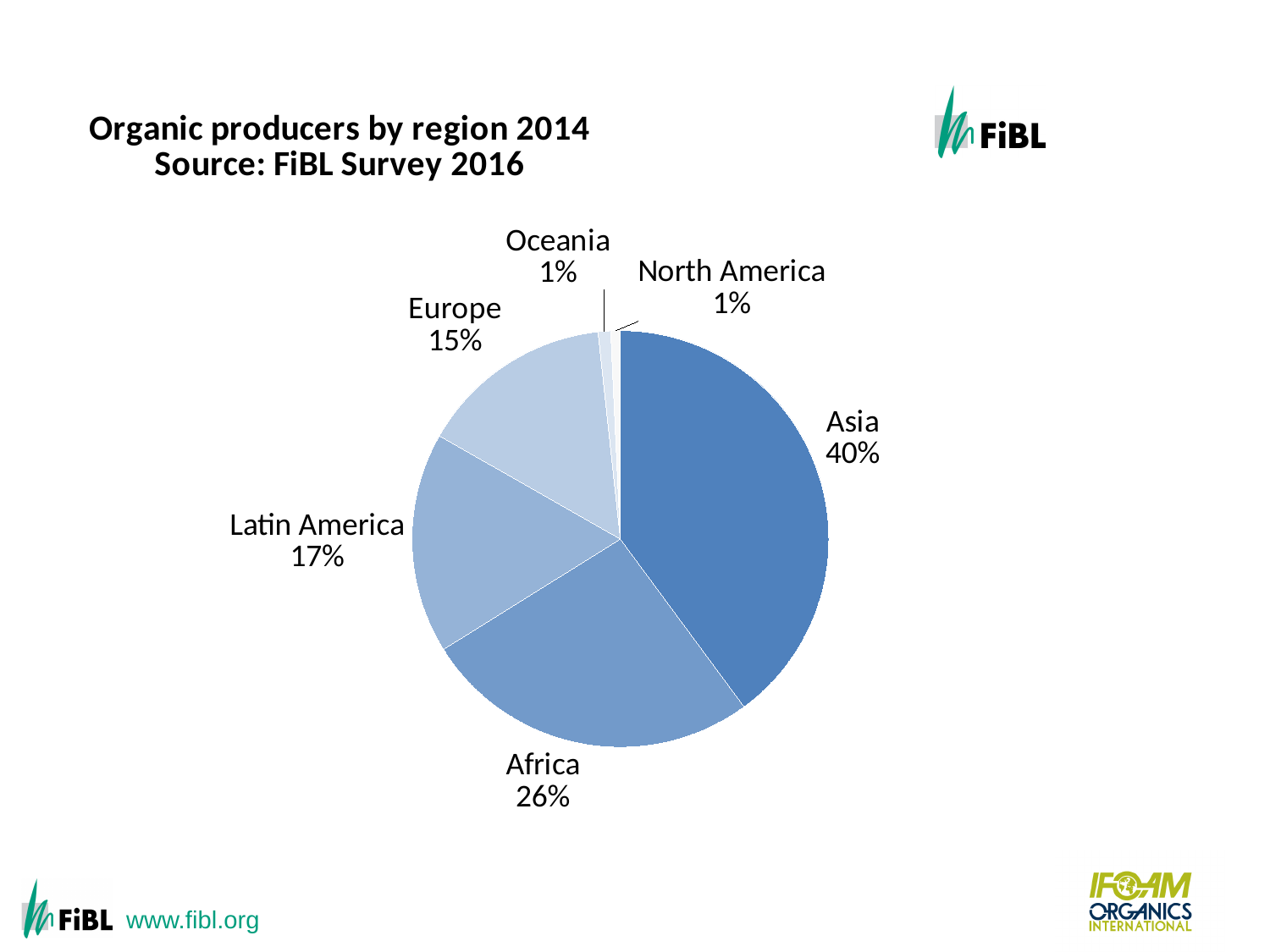
What is the title of the chart? Organic producers by region 2014 What kind of chart is shown on the slide? Pie chart Which has a larger share of organic producers, Africa or Latin America? Africa How many regions are shown in the pie chart? 6 What is the difference in percentage points between Latin America's share and Europe's share? 2 What share of organic producers is in Europe? 15% Which region has the largest share of organic producers? Asia What share of organic producers is in Africa? 26% What is the difference in percentage points between Asia's share and Africa's share? 14 What share of organic producers is in Asia? 40% What is the source given for the chart data? FiBL Survey 2016 What share of organic producers is in Latin America? 17%